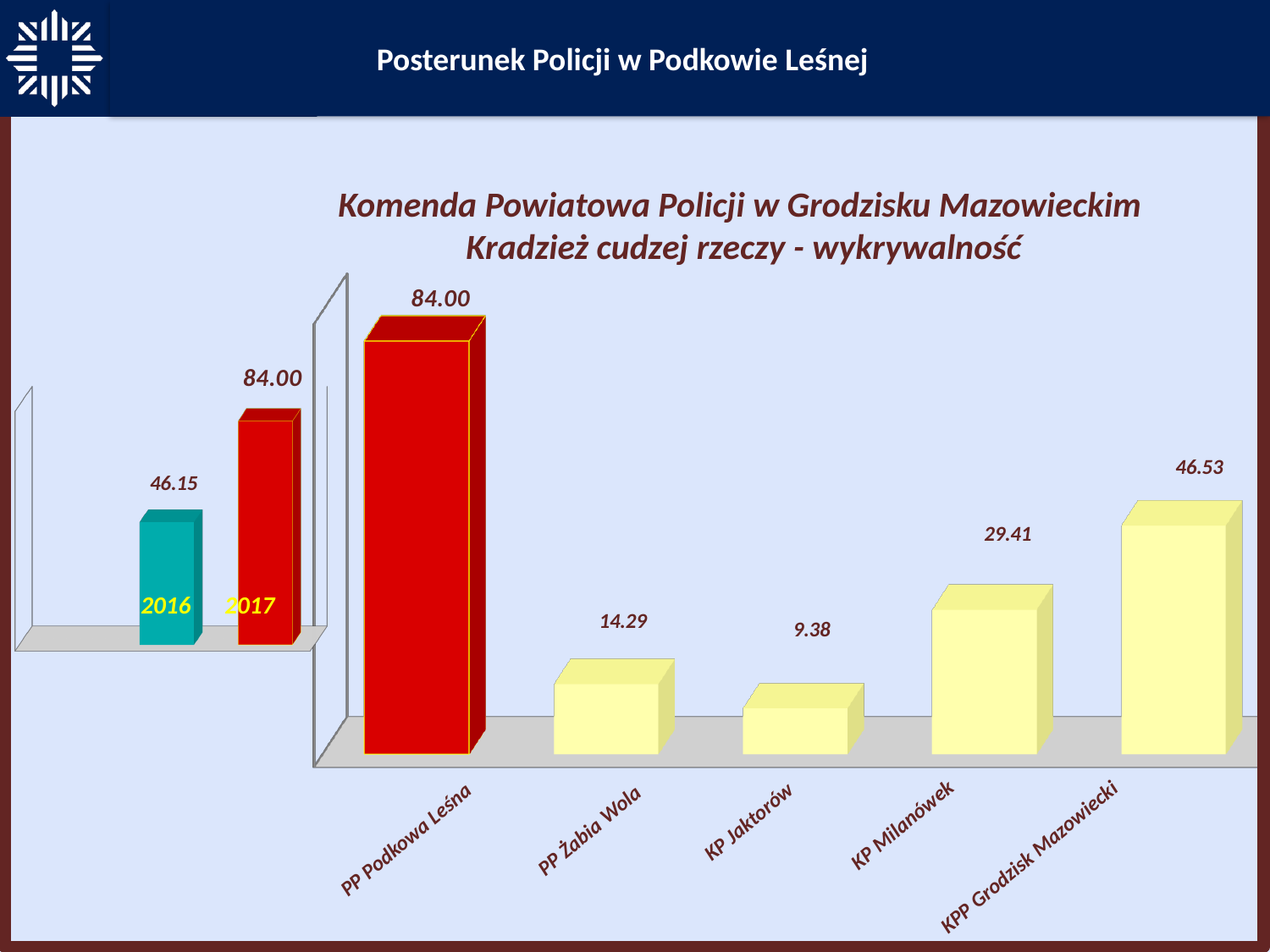
In the large chart titled 'Kradzież cudzej rzeczy - wykrywalność', which category has the highest value? PP Podkowa Leśna What kind of chart is the large chart titled 'Kradzież cudzej rzeczy - wykrywalność'? Bar chart In the small chart on the left of the slide, do the values rise or fall from 2016 to 2017? Rise In the large chart titled 'Kradzież cudzej rzeczy - wykrywalność', what is the value for PP Podkowa Leśna? 84.00 In the large chart titled 'Kradzież cudzej rzeczy - wykrywalność', which category has the lowest value? KP Jaktorów In the small chart on the left of the slide, what is the value for 2016? 46.15 In the large chart titled 'Kradzież cudzej rzeczy - wykrywalność', what is the difference between the values for KP Milanówek and PP Żabia Wola? 15.12 In the large chart titled 'Kradzież cudzej rzeczy - wykrywalność', which is larger: the value for KP Milanówek or KPP Grodzisk Mazowiecki? KPP Grodzisk Mazowiecki In the small chart on the left of the slide, what is the difference between the 2017 and 2016 values? 37.85 How many categories are shown in the large chart titled 'Kradzież cudzej rzeczy - wykrywalność'? 5 In the large chart titled 'Kradzież cudzej rzeczy - wykrywalność', what is the value for KP Jaktorów? 9.38 In the large chart titled 'Kradzież cudzej rzeczy - wykrywalność', what is the value for KPP Grodzisk Mazowiecki? 46.53